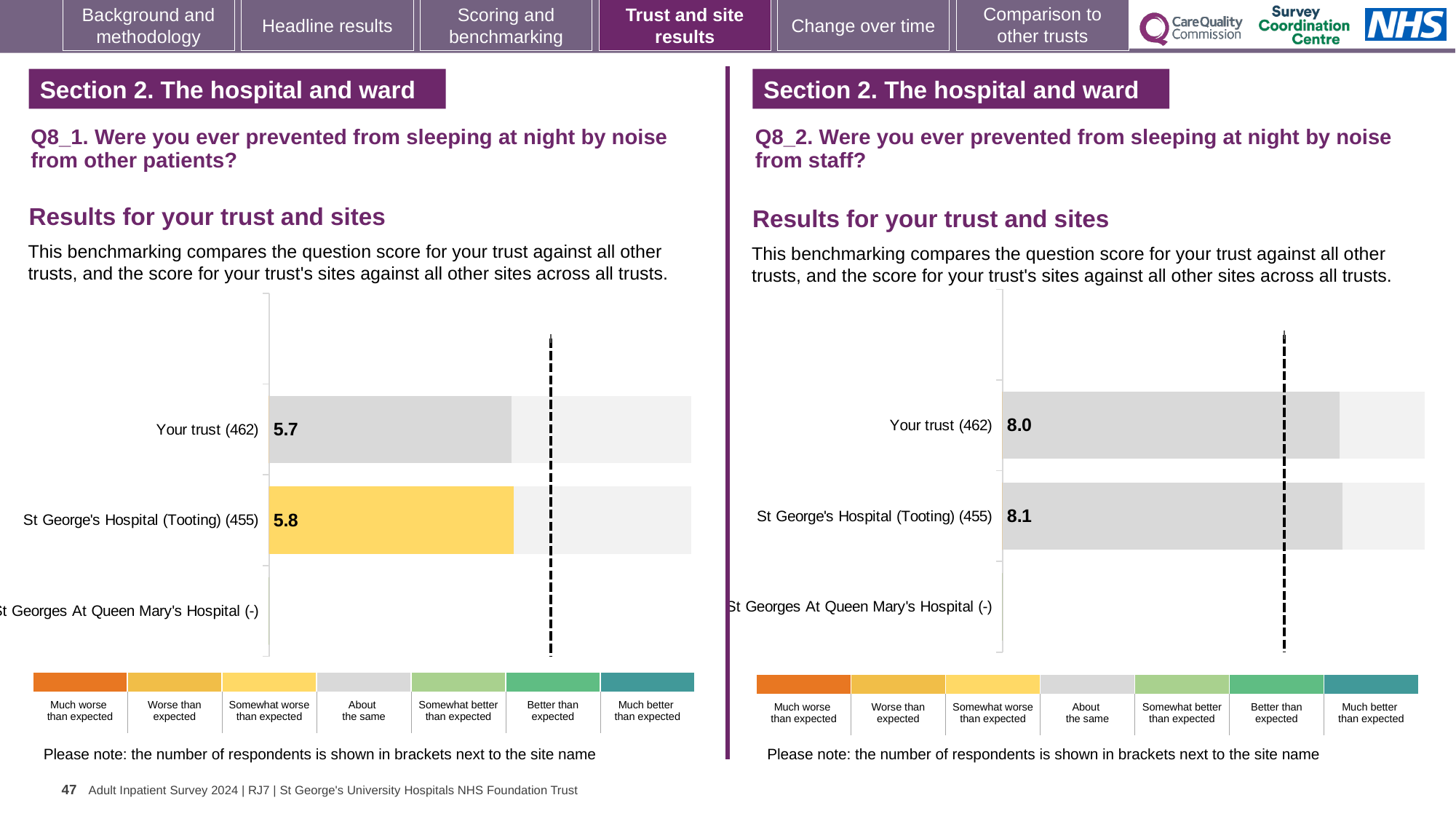
In the Q8_2 chart (right), which has the higher score: Your trust (462) or St George's Hospital (Tooting) (455)? St George's Hospital (Tooting) (455) In the Q8_2 chart (right), what is the difference between the St George's Hospital (Tooting) score and the Your trust score? 0.1 In the Q8_1 chart (left), what is the difference between the St George's Hospital (Tooting) score and the Your trust score? 0.1 In the Q8_1 chart (left), which has the higher score: Your trust (462) or St George's Hospital (Tooting) (455)? St George's Hospital (Tooting) (455) How many category labels are listed on the y axis of the Q8_1 chart (left)? 3 In the Q8_2 chart (right), which benchmark category does the colour of the Your trust (462) bar correspond to? About the same In the Q8_2 chart (right), what is the score for St George's Hospital (Tooting) (455)? 8.1 In the Q8_2 chart (right), what is the score for Your trust (462)? 8.0 In the Q8_1 chart (left), what is the score for Your trust (462)? 5.7 In the Q8_1 chart (left), which benchmark category does the colour of the St George's Hospital (Tooting) bar correspond to? Somewhat worse than expected In the Q8_1 chart (left), what is the score for St George's Hospital (Tooting) (455)? 5.8 What kind of chart is used for the Q8_2 results (right)? Bar chart